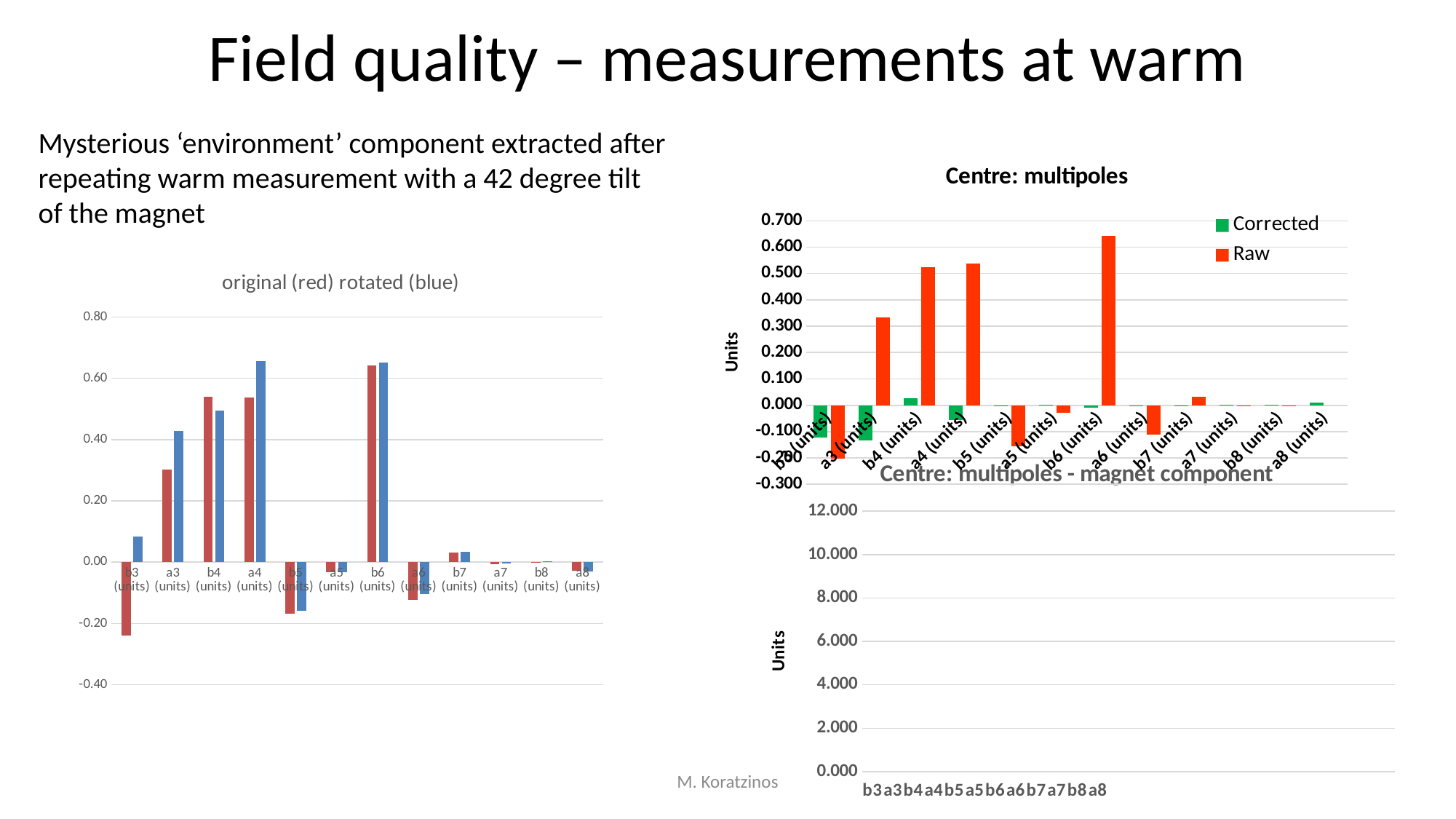
In the 'Centre: multipoles' chart, which has the larger Raw value: a4 or b6? b6 (units) In the 'Centre: multipoles' chart, which category has the lowest Raw value? b3 (units) How many charts are on the slide? 3 In the 'original (red) rotated (blue)' chart, is the blue (rotated) value for a4 greater or less than 0.60? greater In the 'original (red) rotated (blue)' chart, how many categories are shown on the x axis? 12 In the 'original (red) rotated (blue)' chart, which is larger for a3: the red (original) bar or the blue (rotated) bar? blue (rotated) In the 'Centre: multipoles' chart, which category has the highest Raw value? b6 (units) In the 'Centre: multipoles' chart, how many series does the legend list? 2 In the 'original (red) rotated (blue)' chart, what kind of chart is it? bar chart In the 'original (red) rotated (blue)' chart, which category has the highest red (original) bar? b6 (units) In the 'original (red) rotated (blue)' chart, which category has the lowest red (original) bar? b3 (units) In the 'Centre: multipoles' chart, is the Raw value for b4 greater or less than 0.300? greater